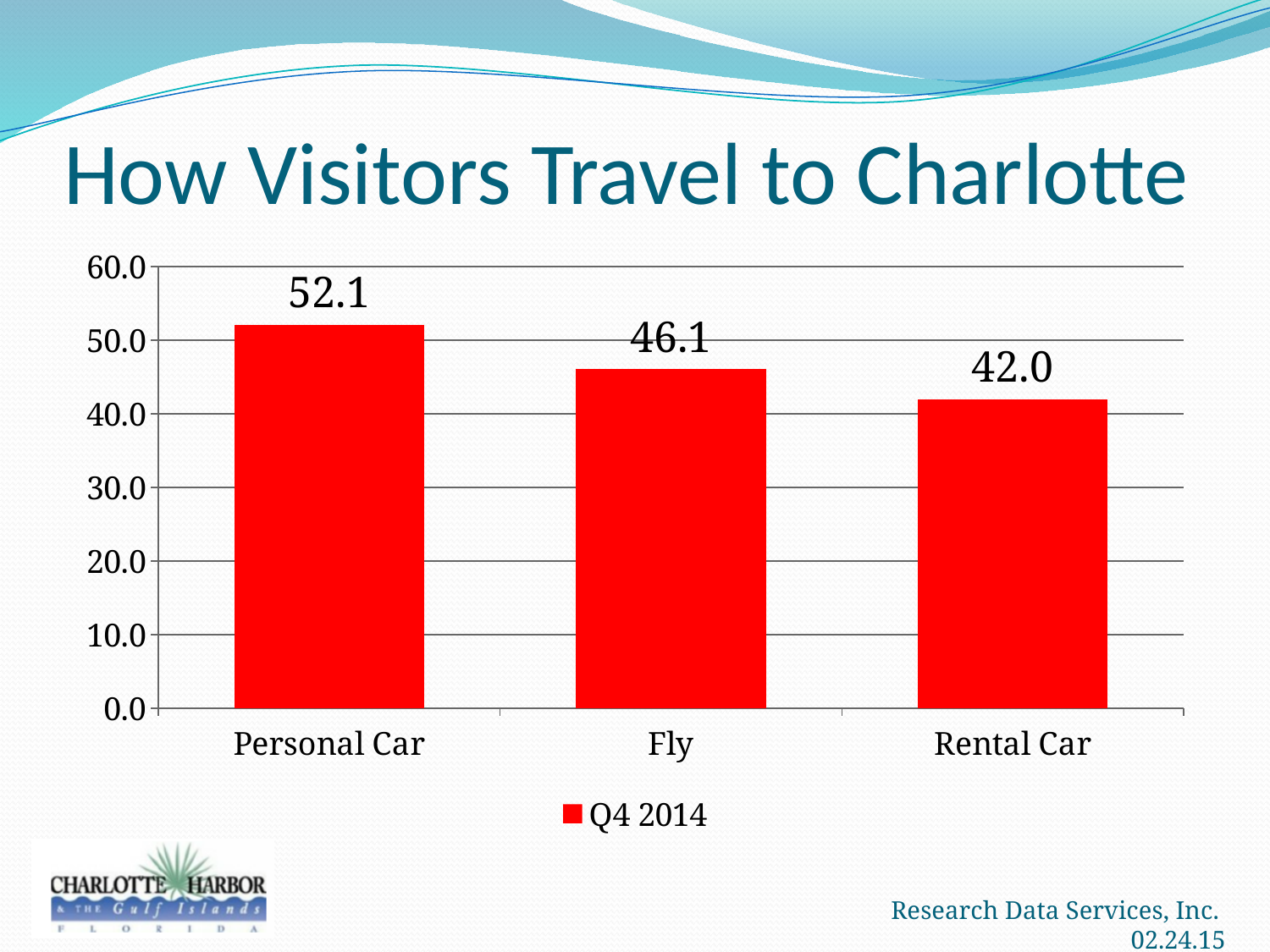
How many categories are shown on the x axis? 3 Which category has the lowest value? Rental Car What is the value for Personal Car? 52.1 Which category has the highest value? Personal Car Is the value for Personal Car greater or less than 50.0? greater Which is larger, the value for Fly or the value for Rental Car? Fly What kind of chart is shown on the slide? bar chart What is the value for Rental Car? 42.0 What series does the legend list? Q4 2014 What is the difference between the values for Fly and Rental Car? 4.1 What is the value for Fly? 46.1 What is the difference between the values for Personal Car and Rental Car? 10.1